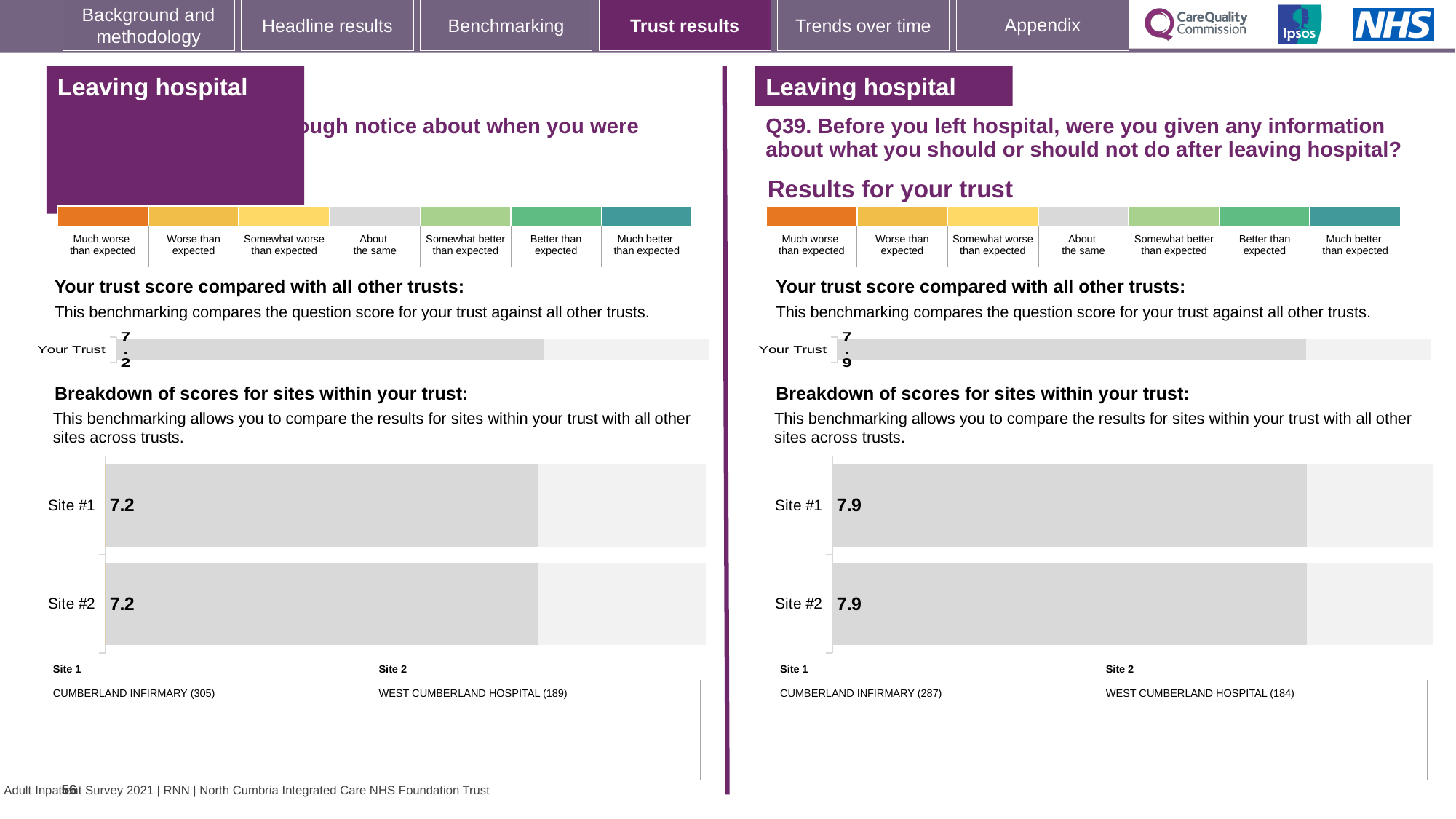
How many sites are shown in the right-hand site breakdown chart (Q39)? 2 Which site is listed as Site 1 beneath the right-hand site breakdown chart (Q39)? CUMBERLAND INFIRMARY (287) Which is larger: the Your Trust score on the left-hand chart or the Your Trust score on the right-hand chart (Q39)? The right-hand chart (Q39) In the left-hand site breakdown chart, what is the score for Site #1? 7.2 In the left-hand site breakdown chart, what is the score for Site #2? 7.2 What type of chart is used for the site breakdown on the left-hand side of the slide? Bar chart On the right-hand chart (Q39), what is the score shown for Your Trust? 7.9 In the right-hand site breakdown chart (Q39), what is the score for Site #1? 7.9 On the left-hand chart, what is the score shown for Your Trust? 7.2 In the left-hand site breakdown chart, what is the difference between the scores for Site #1 and Site #2? 0.0 In the right-hand site breakdown chart (Q39), what is the difference between the Site #1 and Site #2 scores? 0.0 In the right-hand site breakdown chart (Q39), what is the score for Site #2? 7.9